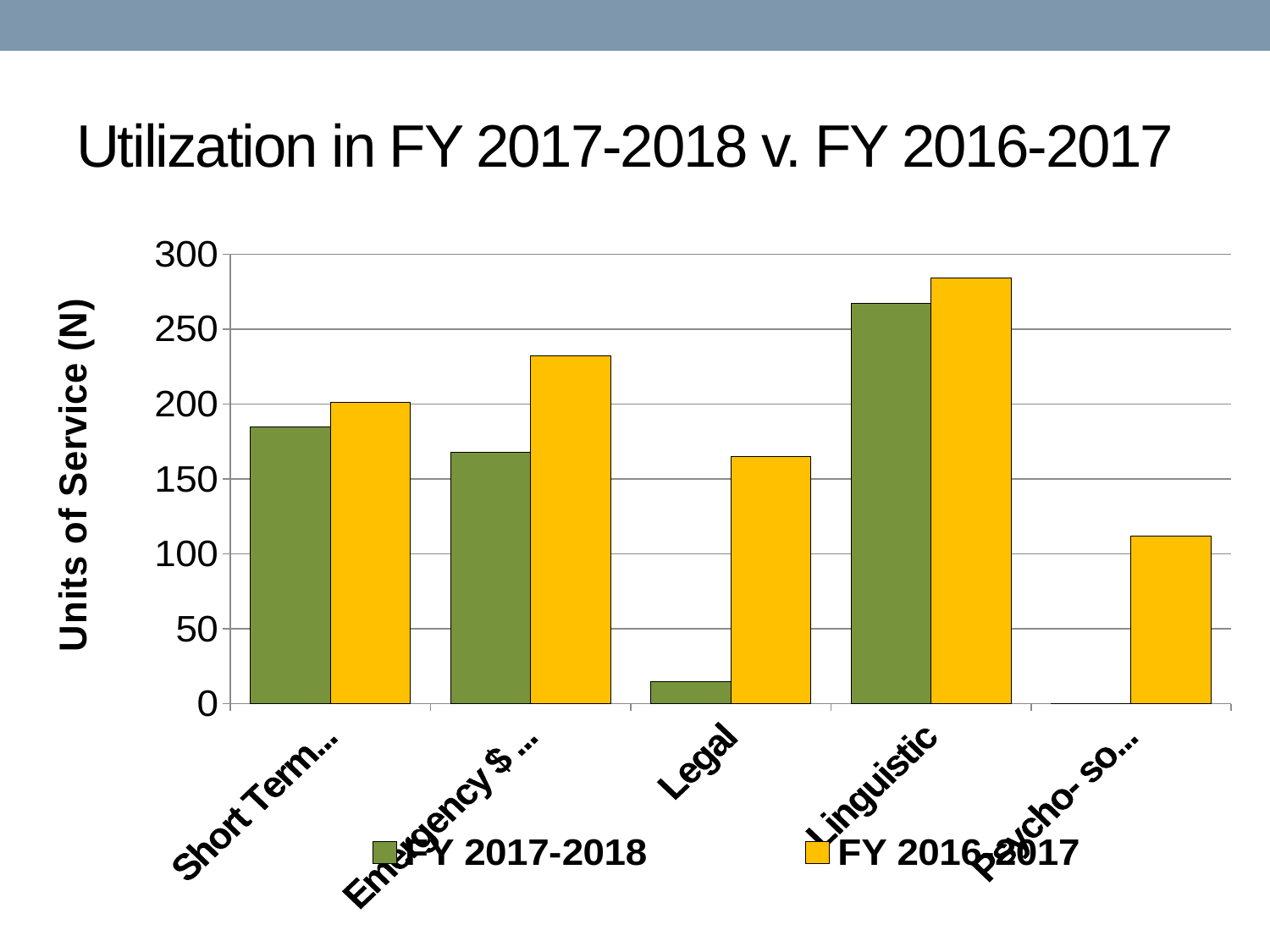
Is the FY 2016-2017 value for Legal greater or less than 150? greater Is the FY 2016-2017 value for Linguistic greater or less than 300? less What is the title of the y axis? Units of Service (N) Which category has the highest value for FY 2017-2018? Linguistic Which colour represents the FY 2017-2018 series? green How many series does the legend list? 2 Is the FY 2017-2018 value for Linguistic greater or less than 250? greater Which category has the highest value for FY 2016-2017? Linguistic What kind of chart is shown on the slide? bar chart For Legal, which series has the larger value, FY 2017-2018 or FY 2016-2017? FY 2016-2017 How many categories are shown on the x axis? 5